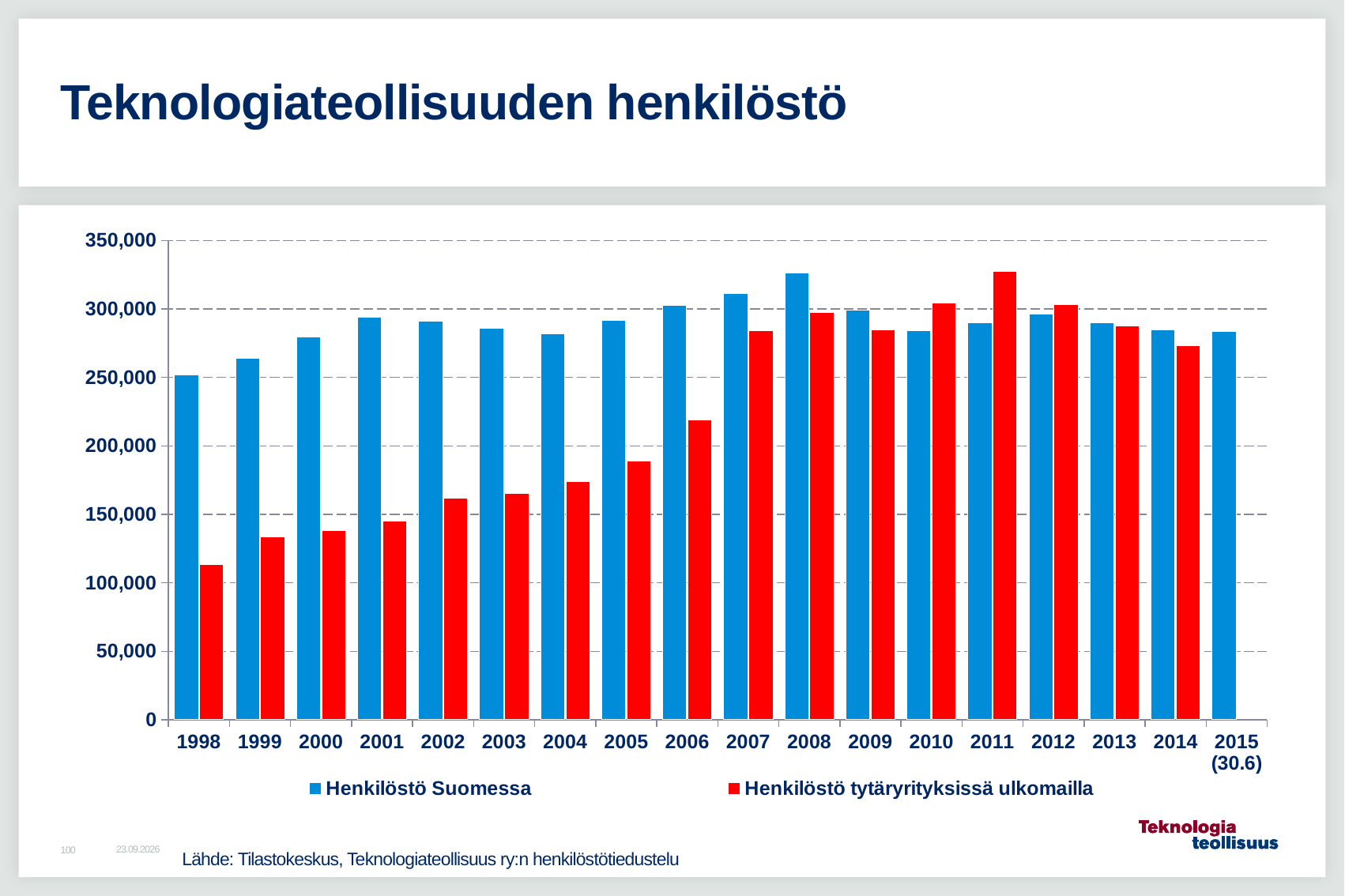
What kind of chart is shown on the slide? bar chart Is the value for Henkilöstö Suomessa in 2008 greater or less than 300,000? greater Is the value for Henkilöstö tytäryrityksissä ulkomailla in 2014 greater or less than 300,000? less Which year has the highest value for Henkilöstö tytäryrityksissä ulkomailla? 2011 Which year has the lowest value for Henkilöstö Suomessa? 1998 Which year has the lowest value for Henkilöstö tytäryrityksissä ulkomailla? 1998 How many years are shown on the x axis? 18 In 2011, which is larger: Henkilöstö Suomessa or Henkilöstö tytäryrityksissä ulkomailla? Henkilöstö tytäryrityksissä ulkomailla Does the value for Henkilöstö tytäryrityksissä ulkomailla rise or fall from 1998 to 2008? rise How many series does the legend list? 2 Is the value for Henkilöstö tytäryrityksissä ulkomailla in 1998 greater or less than 150,000? less Which year has the highest value for Henkilöstö Suomessa? 2008